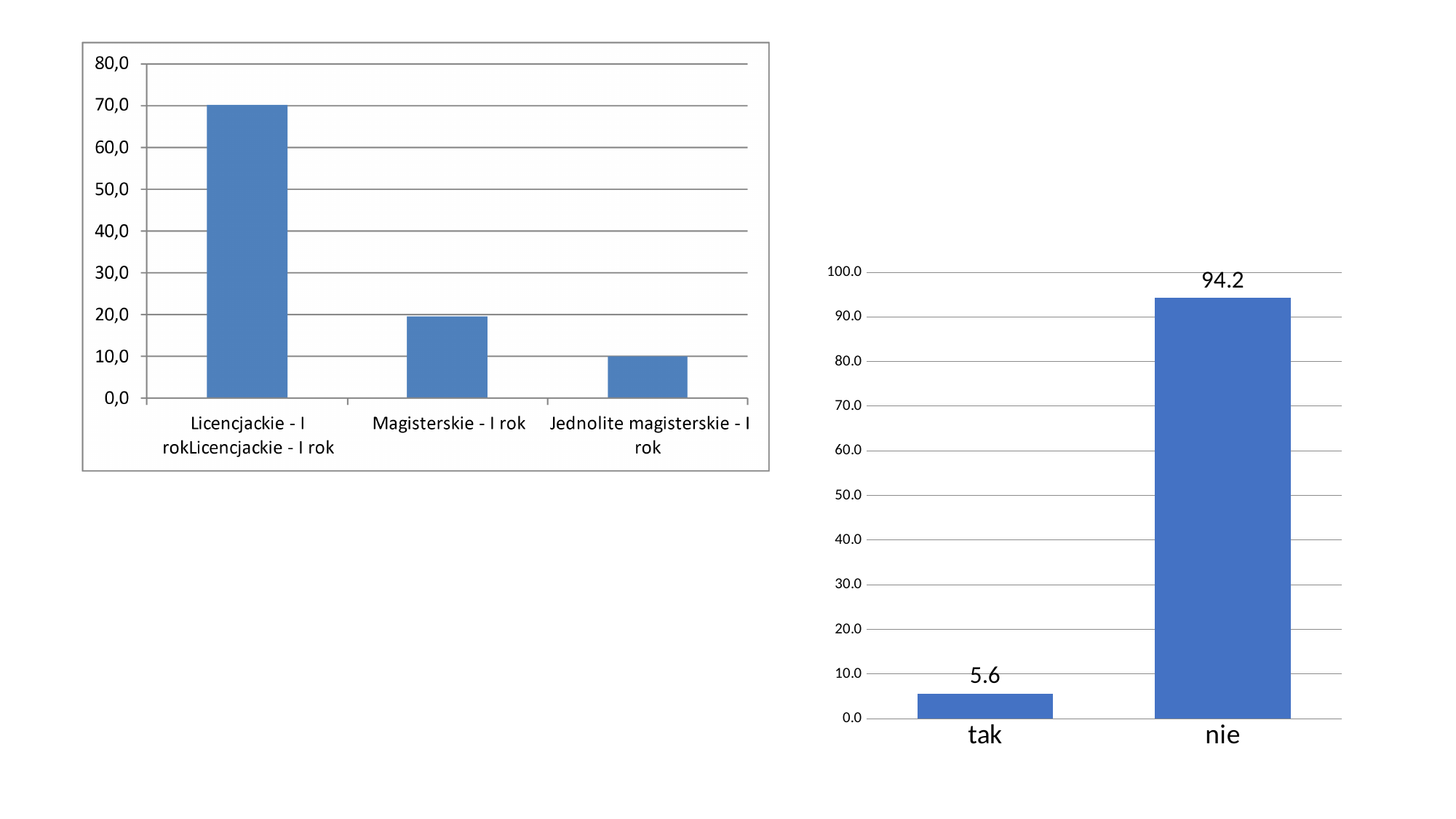
On the right chart, what is the value for "tak"? 5.6 On the left chart, which category has the highest value? Licencjackie - I rok On the left chart, how many bars are shown? 3 On the left chart, which category has the lowest value? Jednolite magisterskie - I rok On the right chart, how many categories are shown? 2 On the left chart, is the value for "Licencjackie - I rok" greater or less than 60,0? greater On the left chart, which is larger: the value for "Magisterskie - I rok" or "Jednolite magisterskie - I rok"? Magisterskie - I rok On the right chart, which category has the higher value? nie On the left chart, is the value for "Magisterskie - I rok" greater or less than 30,0? less On the right chart, what is the value for "nie"? 94.2 On the right chart, what is the difference between the values for "nie" and "tak"? 88.6 What kind of chart is the right chart? bar chart